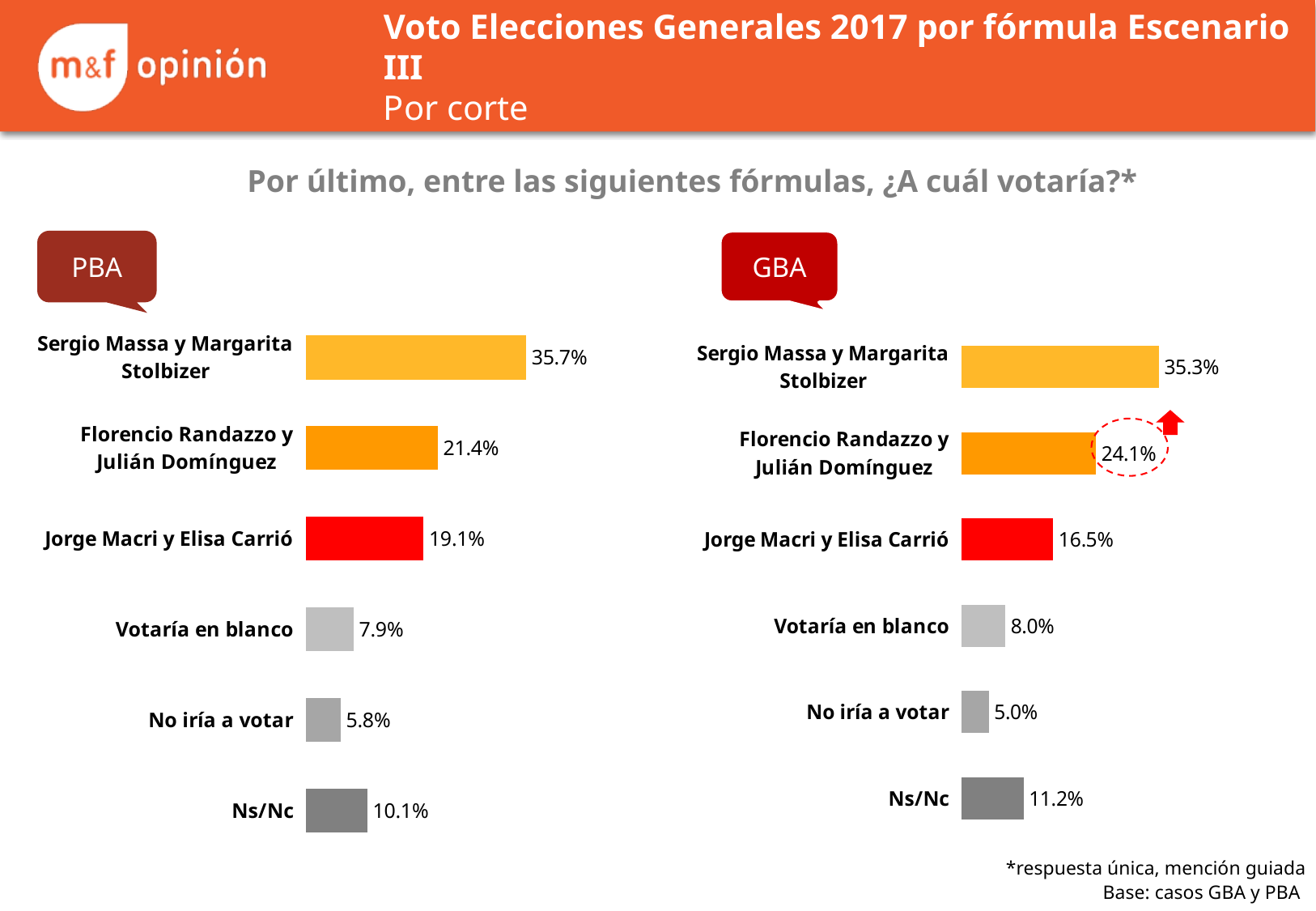
In the PBA chart, what is the value for Ns/Nc? 10.1% In the GBA chart, which category has the lowest value? No iría a votar Which is larger: Votaría en blanco in the PBA chart or Votaría en blanco in the GBA chart? GBA In the GBA chart, which category's value is circled with a dashed red outline? Florencio Randazzo y Julián Domínguez In the PBA chart, what is the difference between Sergio Massa y Margarita Stolbizer and Florencio Randazzo y Julián Domínguez? 14.3% In the GBA chart, what is the difference between Florencio Randazzo y Julián Domínguez and Jorge Macri y Elisa Carrió? 7.6% In the GBA chart, what is the value for Jorge Macri y Elisa Carrió? 16.5% In the GBA chart, what is the value for Florencio Randazzo y Julián Domínguez? 24.1% In the PBA chart, what is the value for Sergio Massa y Margarita Stolbizer? 35.7% What kind of chart is the GBA chart? Bar chart How many categories does the PBA chart show? 6 In the PBA chart, which category has the highest value? Sergio Massa y Margarita Stolbizer